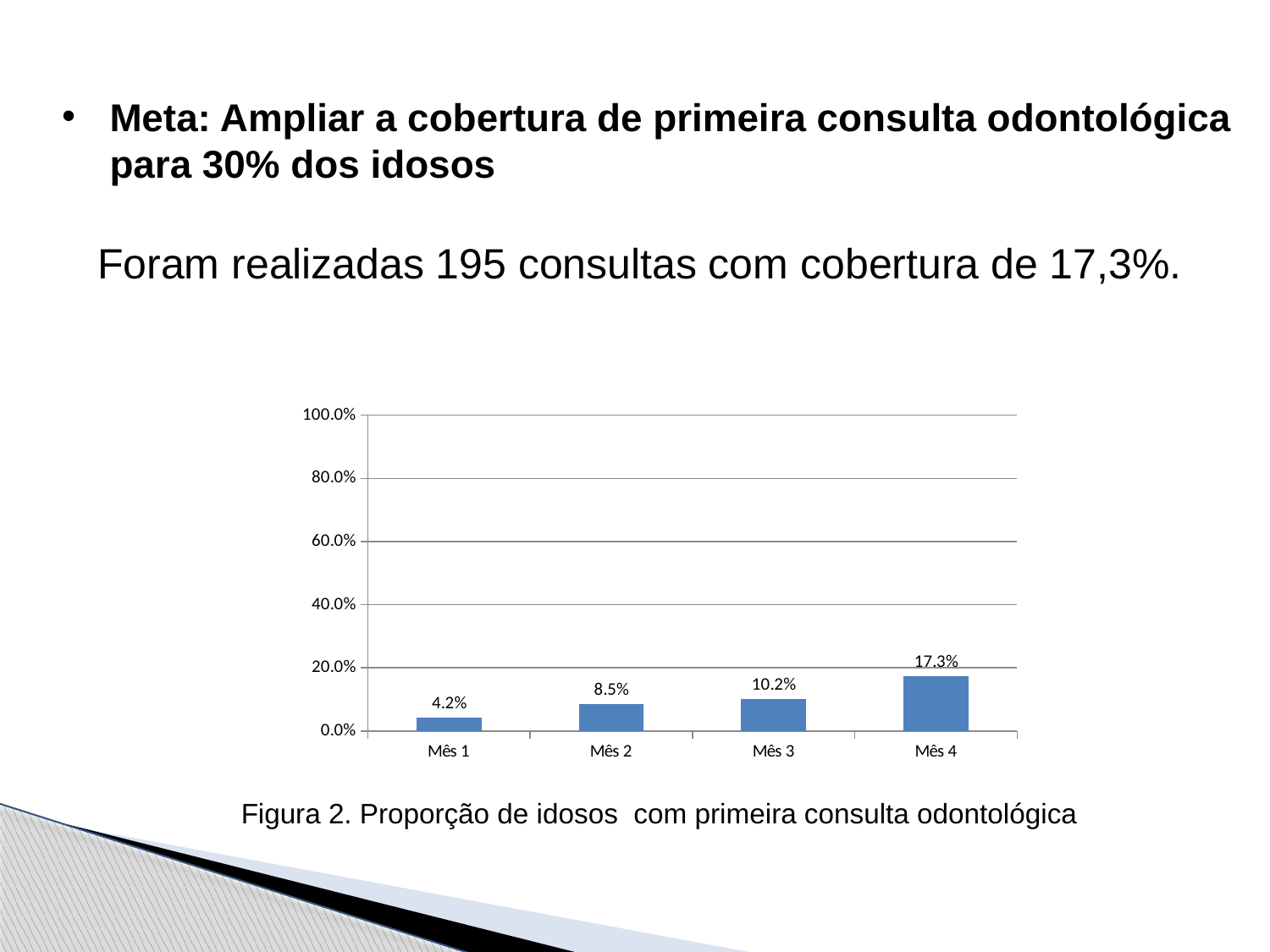
What is the difference between the values for Mês 4 and Mês 1? 13.1% Is the value for Mês 4 greater or less than 20.0%? less Which month has the highest value? Mês 4 How many months are shown on the x axis? 4 What is the value for Mês 2? 8.5% What is the value for Mês 4? 17.3% What is the value for Mês 3? 10.2% What is the value for Mês 1? 4.2% Which is larger, the value for Mês 2 or the value for Mês 3? Mês 3 Do the values rise or fall from Mês 1 to Mês 4? rise What kind of chart is shown on the slide? bar chart Which month has the lowest value? Mês 1